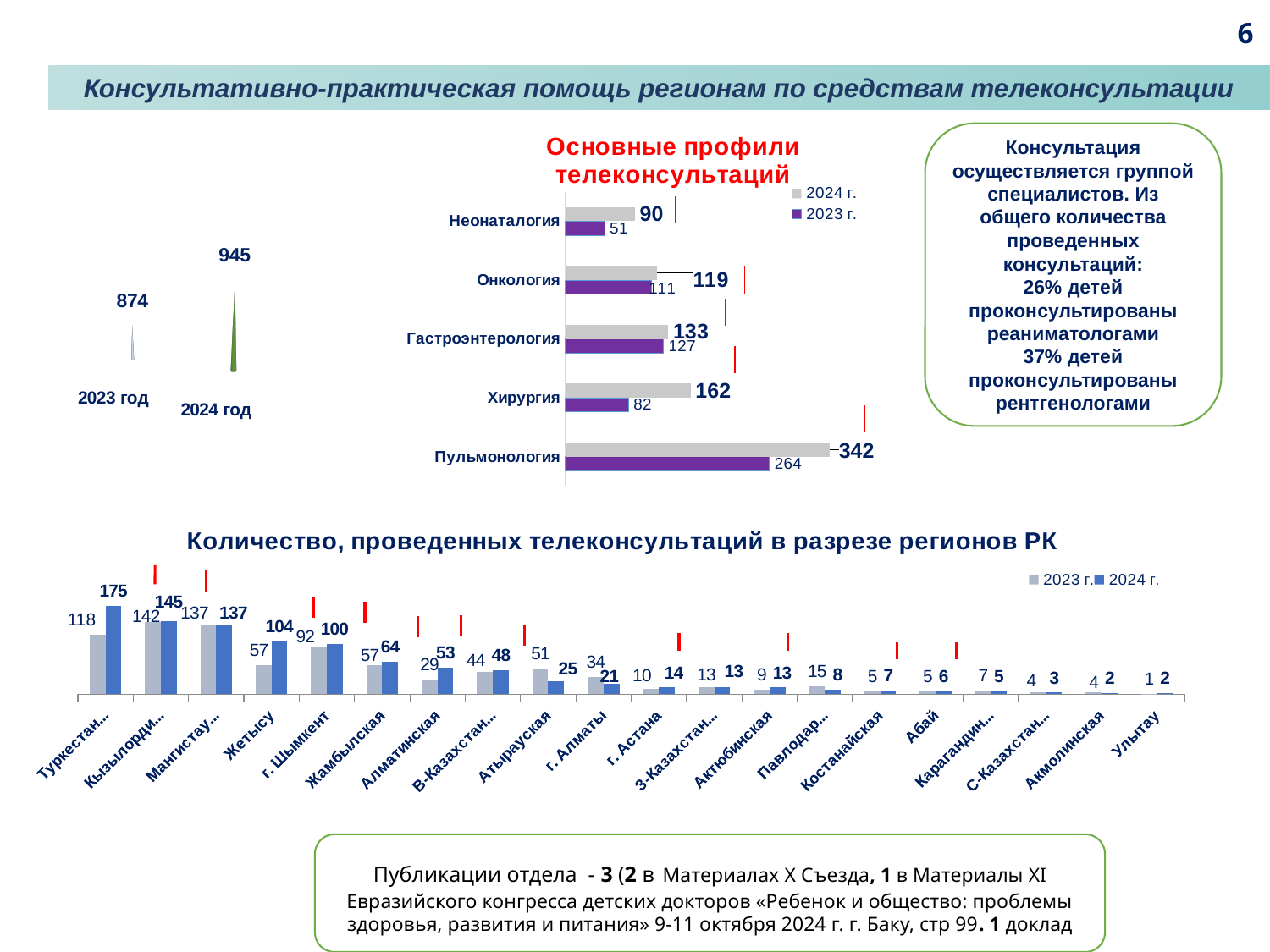
In the chart 'Количество, проведенных телеконсультаций в разрезе регионов РК', which is larger for г. Алматы: the 2023 value or the 2024 value? 2023 г. What type of chart is 'Количество, проведенных телеконсультаций в разрезе регионов РК'? bar chart In the chart 'Основные профили телеконсультаций', how many series does the legend list? 2 In the chart 'Основные профили телеконсультаций', what is the 2024 value for Пульмонология? 342 In the chart 'Основные профили телеконсультаций', which profile has the highest 2024 value? Пульмонология In the chart 'Основные профили телеконсультаций', how many profiles are shown? 5 In the small chart on the left of the slide, what is the difference between the 2024 год value and the 2023 год value? 71 In the chart 'Основные профили телеконсультаций', what is the difference between the 2024 and 2023 values for Неонаталогия? 39 In the chart 'Количество, проведенных телеконсультаций в разрезе регионов РК', what is the 2023 value for Атырауская? 51 In the chart 'Количество, проведенных телеконсультаций в разрезе регионов РК', what is the 2024 value for Жетысу? 104 In the chart 'Количество, проведенных телеконсультаций в разрезе регионов РК', what is the difference between the 2024 and 2023 values for Алматинская? 24 In the chart 'Основные профили телеконсультаций', what is the 2023 value for Хирургия? 82